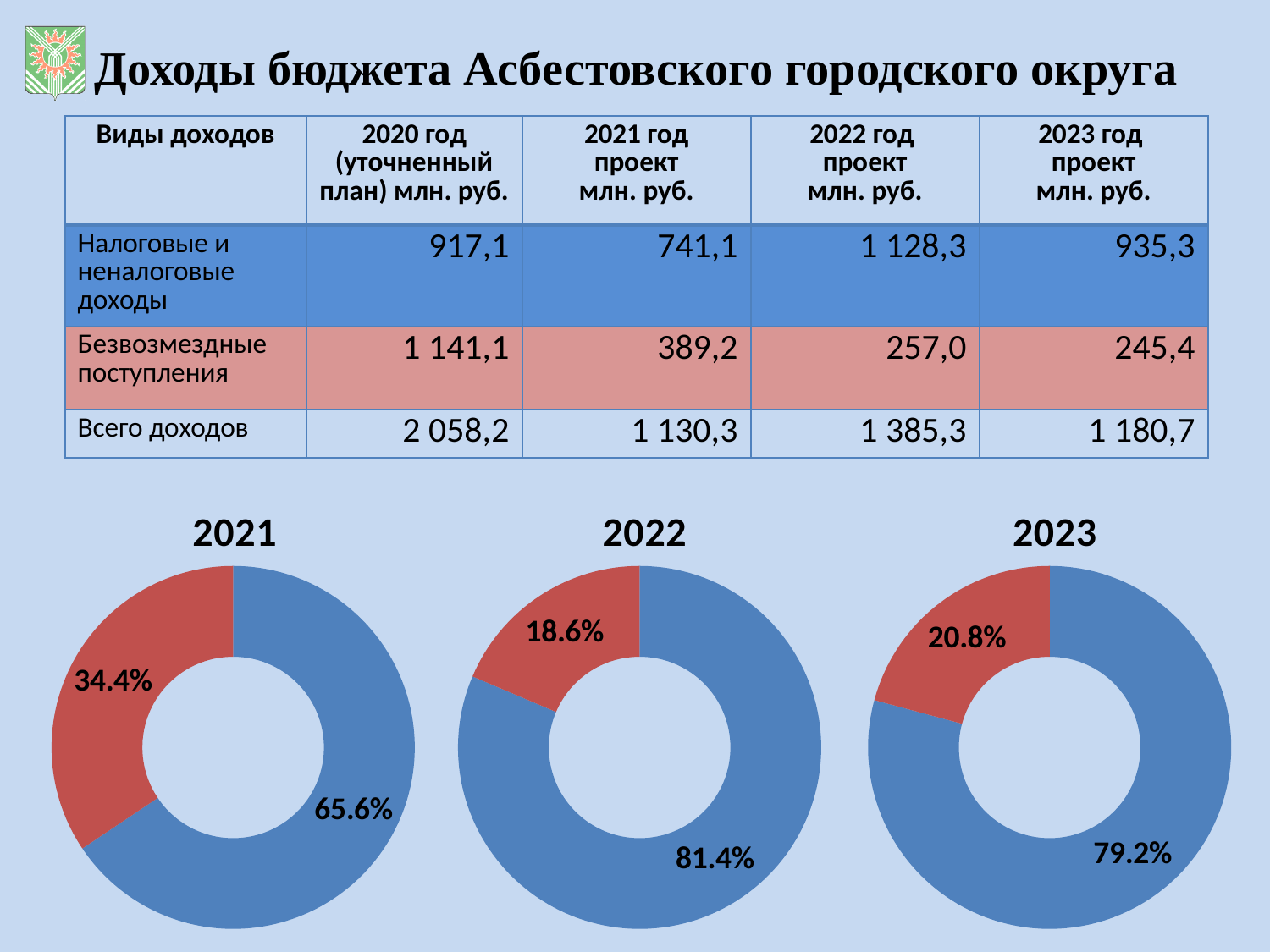
In the 2021 chart, what share does the red slice have? 34.4% What is the difference between the blue slice's share in the 2022 chart and the blue slice's share in the 2021 chart? 15.8 percentage points Across the three doughnut charts, in which year is the red slice's share the smallest? 2022 In the 2023 chart, what share does the red slice have? 20.8% In the 2023 chart, which slice is larger, the blue one or the red one? The blue one In the 2022 chart, what share does the blue slice have? 81.4% In the 2022 chart, what share does the red slice have? 18.6% Across the three doughnut charts, in which year is the red slice's share the largest? 2021 How many slices does each doughnut chart on the slide have? 2 In the 2023 chart, what share does the blue slice have? 79.2% What kind of chart is used for the 2021, 2022 and 2023 charts on the slide? Doughnut chart In the 2021 chart, what share does the blue slice have? 65.6%